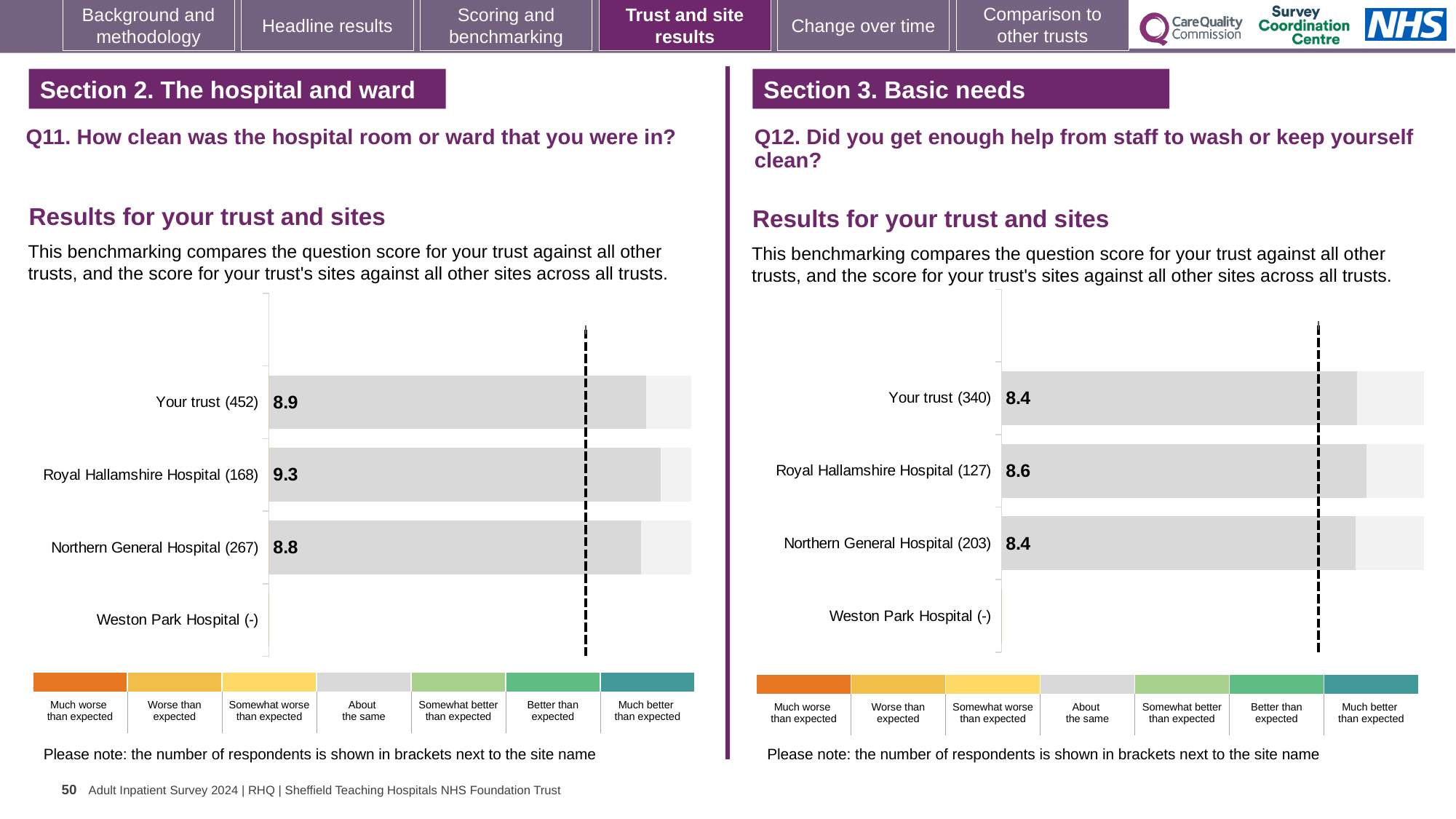
In the Q11 chart (left), what is the difference between the scores for Royal Hallamshire Hospital and Northern General Hospital? 0.5 In the Q12 chart (right), how many respondents are shown in brackets for Your trust? 340 In the Q11 chart (left), what is the score for Your trust? 8.9 In the Q12 chart (right), which site has the highest score? Royal Hallamshire Hospital In the Q12 chart (right), what is the score for Royal Hallamshire Hospital? 8.6 In the Q11 chart (left), how many respondents are shown in brackets for Northern General Hospital? 267 What kind of chart is used for the Q11 results on the left? Bar chart In the Q12 chart (right), what is the score for Northern General Hospital? 8.4 In the Q11 chart (left), what is the score for Royal Hallamshire Hospital? 9.3 In the Q11 chart (left), which site has the highest score? Royal Hallamshire Hospital In the Q11 chart (left), how many site rows are listed, including Your trust? 4 In the Q12 chart (right), what is the difference between the scores for Royal Hallamshire Hospital and Your trust? 0.2